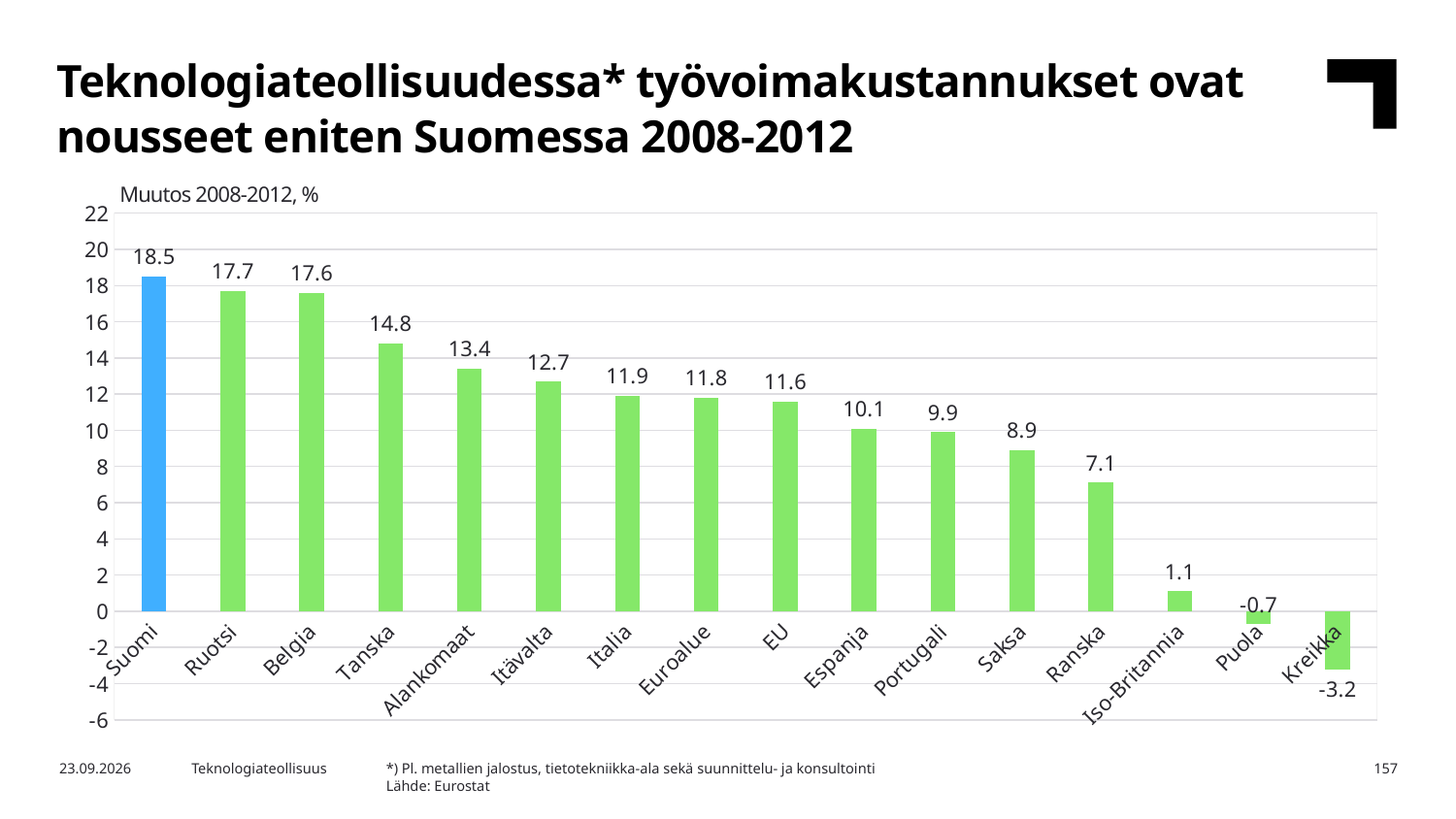
What is the difference between the values for Suomi and Ruotsi? 0.8 Do the values rise or fall from left to right along the x axis? fall What is the value for Kreikka? -3.2 What is the value for Alankomaat? 13.4 What is the difference between the values for Tanska and Saksa? 5.9 Is the value for Portugali greater or less than 8? greater Which country has the lowest value? Kreikka How many categories are shown on the x axis? 16 Which is larger, the value for Espanja or the value for Ranska? Espanja Which country has the highest value? Suomi What is the value for Suomi? 18.5 What kind of chart is shown on the slide? bar chart